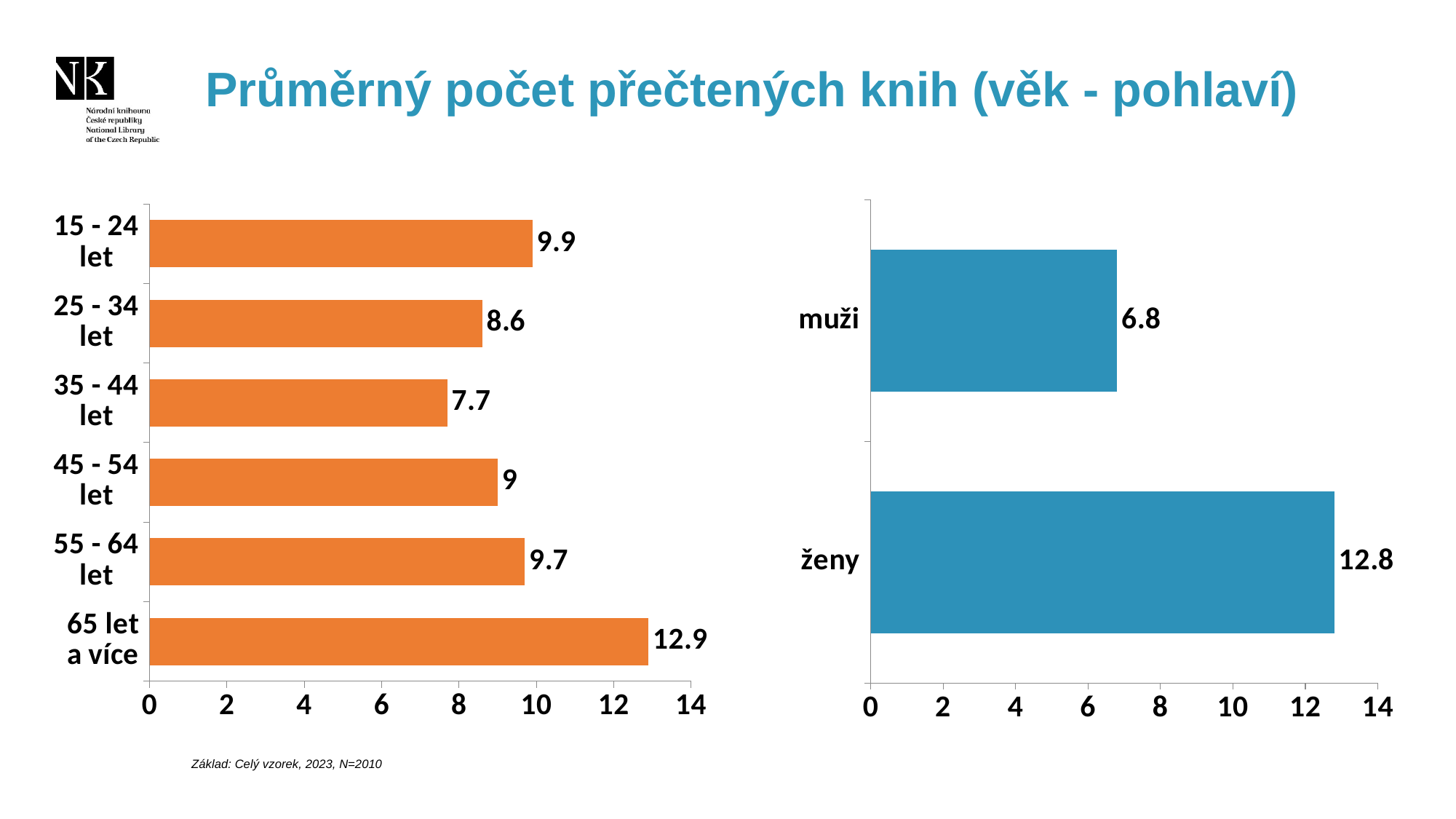
In the right chart (by gender), what is the difference between the values for ženy and muži? 6 In the left chart (by age), how many age groups are shown? 6 In the left chart (by age), which age group has the highest value? 65 let a více In the left chart (by age), which age group has the lowest value? 35 - 44 let What is the title of the slide? Průměrný počet přečtených knih (věk - pohlaví) In the left chart (by age), what is the difference between the values for 65 let a více and 25 - 34 let? 4.3 In the left chart (by age), what is the value for 35 - 44 let? 7.7 In the right chart (by gender), what is the value for muži? 6.8 What kind of chart is the right chart (by gender)? Bar chart In the left chart (by age), what is the value for 15 - 24 let? 9.9 In the right chart (by gender), what is the value for ženy? 12.8 In the left chart (by age), which is larger: the value for 45 - 54 let or for 55 - 64 let? 55 - 64 let